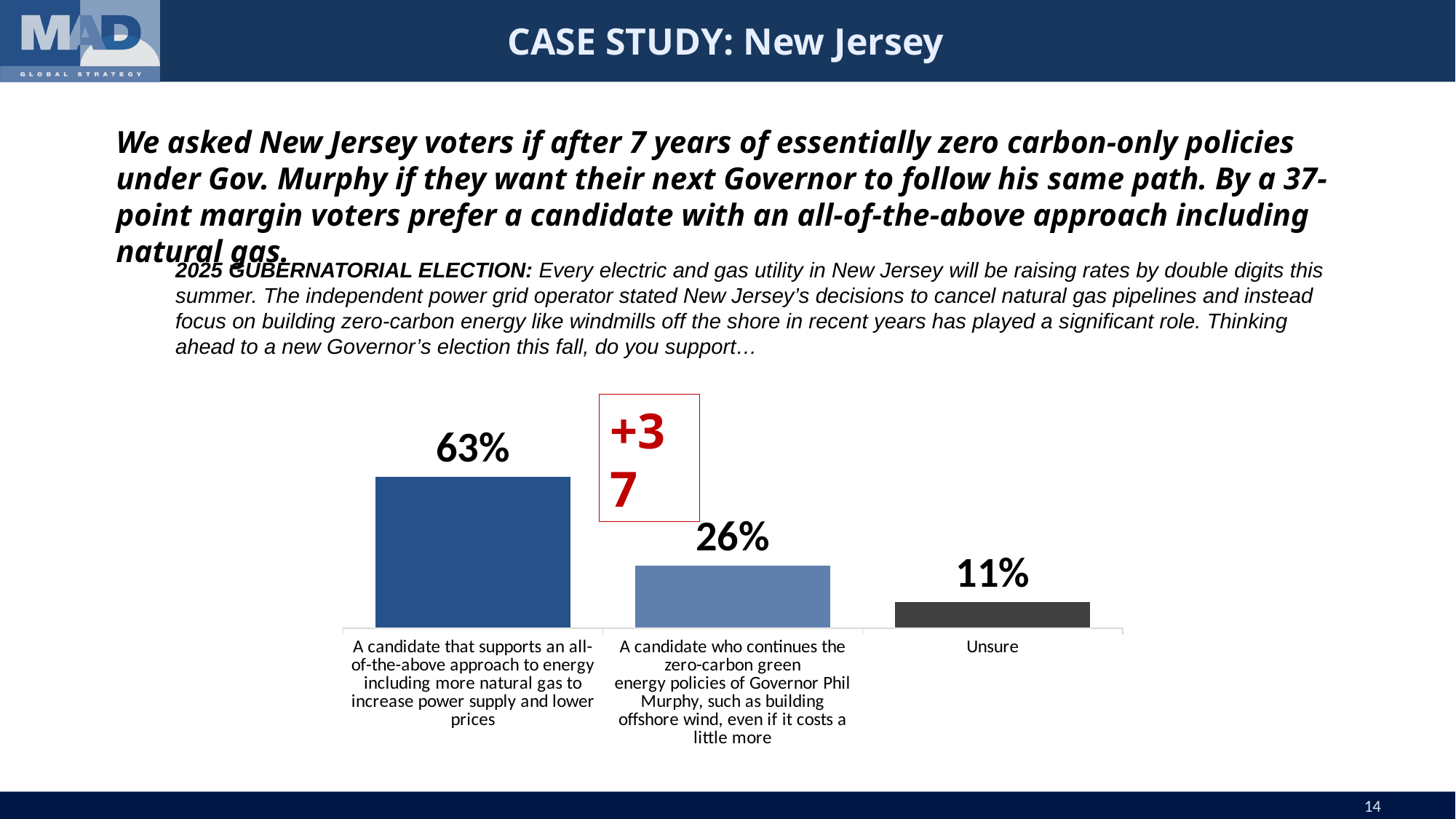
What margin is shown in the red callout box between the first two bars? +37 What is the difference between the all-of-the-above candidate and the zero-carbon candidate? 37 points What percentage of voters support a candidate who continues the zero-carbon green energy policies of Governor Phil Murphy? 26% What is the difference between the zero-carbon candidate and Unsure? 15 points What percentage of voters support a candidate that supports an all-of-the-above approach to energy including more natural gas? 63% What colour is the Unsure bar? Dark grey What kind of chart is shown on the slide? Bar chart How many categories are shown in the chart? 3 Which is larger: the value for the zero-carbon candidate or the value for Unsure? The zero-carbon candidate What percentage of voters are Unsure? 11% Which category has the lowest value? Unsure Which category has the highest value? A candidate that supports an all-of-the-above approach to energy including more natural gas to increase power supply and lower prices